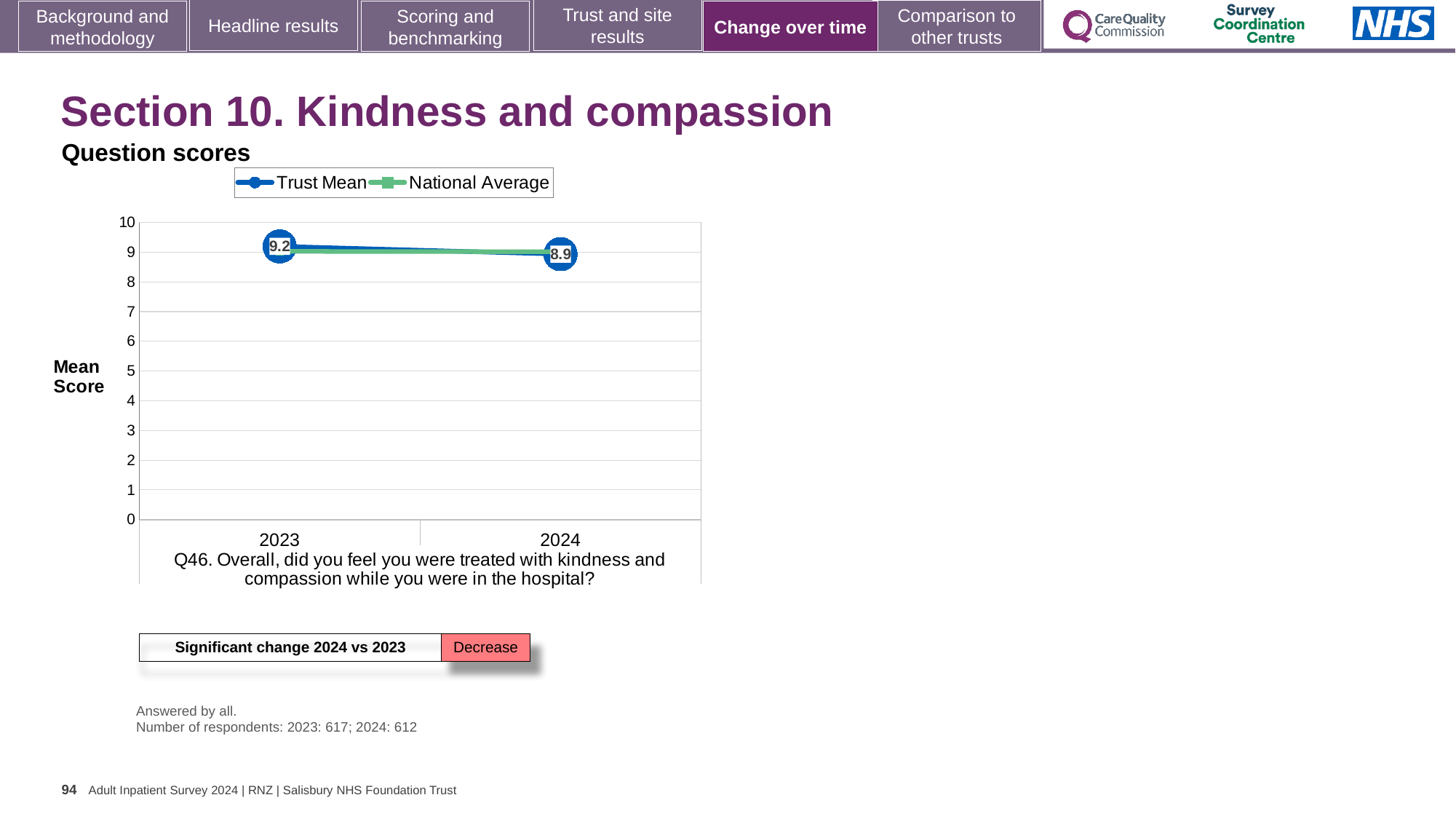
What is the Trust Mean score for 2024? 8.9 Is the Trust Mean score for 2024 greater or less than 8? greater Which year has the higher Trust Mean score, 2023 or 2024? 2023 How many years are shown on the x axis of the chart? 2 What kind of chart is shown on the slide? line chart Is the National Average for 2023 greater or less than 8? greater By how much did the Trust Mean score change from 2023 to 2024? 0.3 How many series does the chart legend list? 2 Which year has the lowest Trust Mean score? 2024 Does the Trust Mean score rise or fall from 2023 to 2024? fall What are the two series named in the chart legend? Trust Mean and National Average What is the Trust Mean score for 2023? 9.2